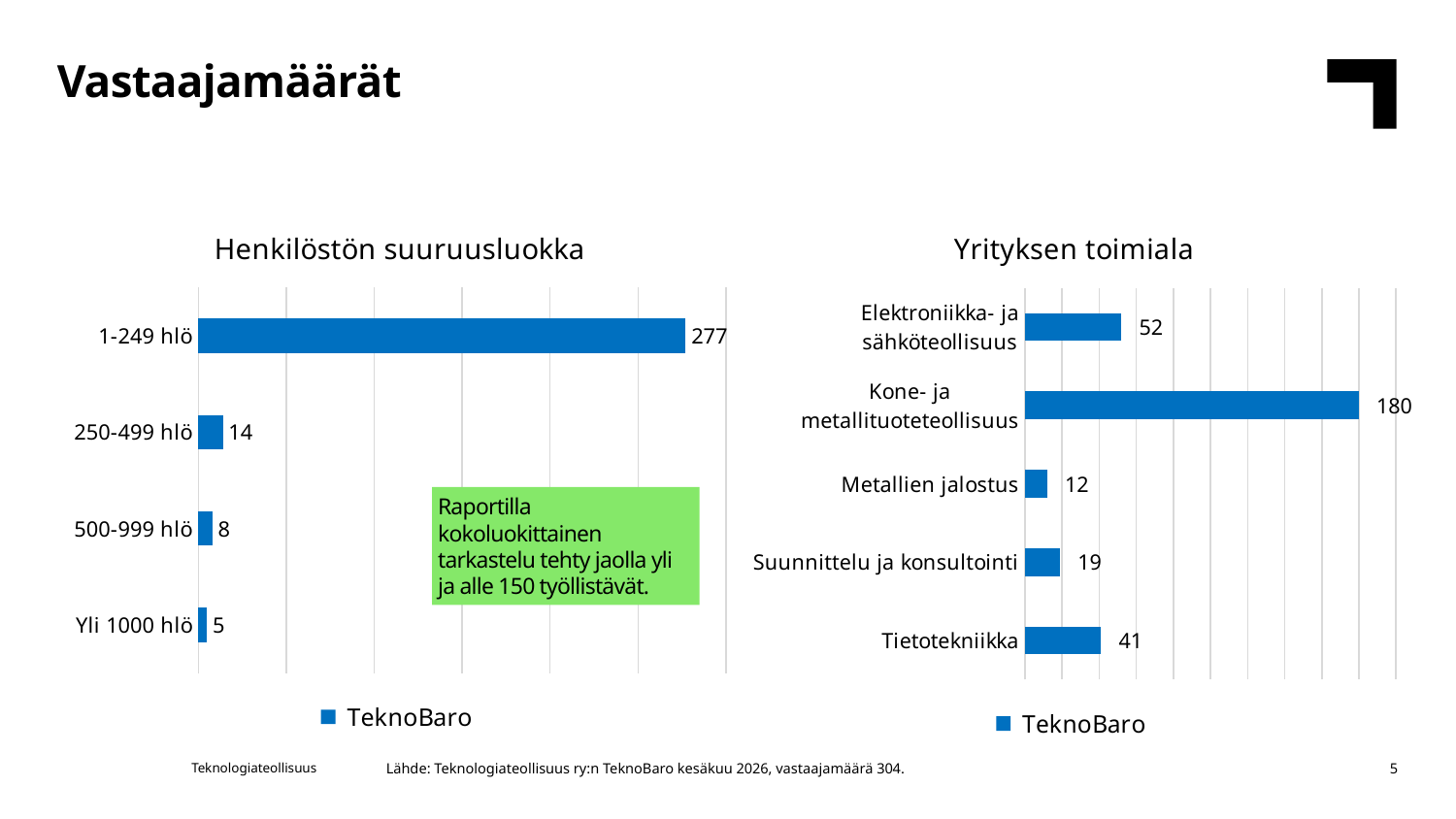
In the 'Yrityksen toimiala' chart, which category has the lowest value? Metallien jalostus In the 'Yrityksen toimiala' chart, which is larger: the value for Elektroniikka- ja sähköteollisuus or the value for Tietotekniikka? Elektroniikka- ja sähköteollisuus In the 'Yrityksen toimiala' chart, what is the value for Tietotekniikka? 41 In the 'Yrityksen toimiala' chart, what is the value for Suunnittelu ja konsultointi? 19 In the 'Yrityksen toimiala' chart, which category has the highest value? Kone- ja metallituoteteollisuus In the 'Yrityksen toimiala' chart, what is the difference between the values for Kone- ja metallituoteteollisuus and Elektroniikka- ja sähköteollisuus? 128 In the 'Henkilöstön suuruusluokka' chart, what is the difference between the values for 500-999 hlö and Yli 1000 hlö? 3 In the 'Henkilöstön suuruusluokka' chart, what is the value for 250-499 hlö? 14 In the 'Henkilöstön suuruusluokka' chart, which category has the lowest value? Yli 1000 hlö In the 'Henkilöstön suuruusluokka' chart, what is the value for 1-249 hlö? 277 What type of chart is the 'Yrityksen toimiala' chart? Bar chart In the 'Henkilöstön suuruusluokka' chart, how many categories are shown? 4